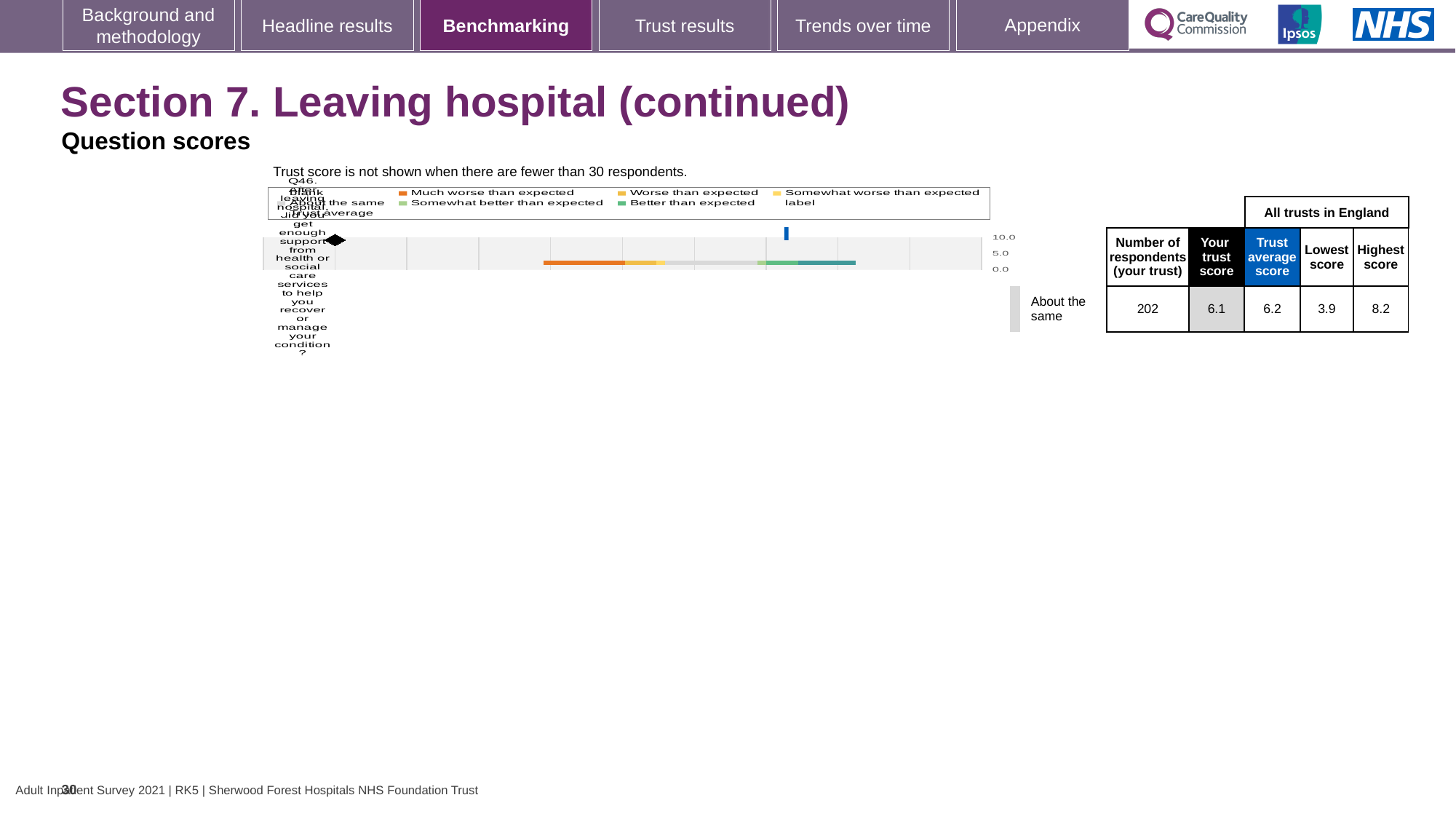
What is the difference between the highest and lowest scores for Q46 across all trusts in England? 4.3 What is the lowest score among all trusts in England for Q46? 3.9 Is the trust score for Q46 greater or less than 5.0 on the chart axis? greater What is the trust average score across all trusts in England for Q46? 6.2 What is the maximum value shown on the chart's score axis? 10.0 What is the trust score for Q46 (support from health or social care services after leaving hospital)? 6.1 What is the difference between the trust average score and the trust's own score for Q46? 0.1 What kind of chart is used to show the Q46 benchmarking result? Bar chart How many respondents from the trust answered Q46? 202 How is the trust's Q46 score categorised relative to expectations? About the same Which is larger for Q46: the trust's own score or the trust average score? Trust average score What is the highest score among all trusts in England for Q46? 8.2